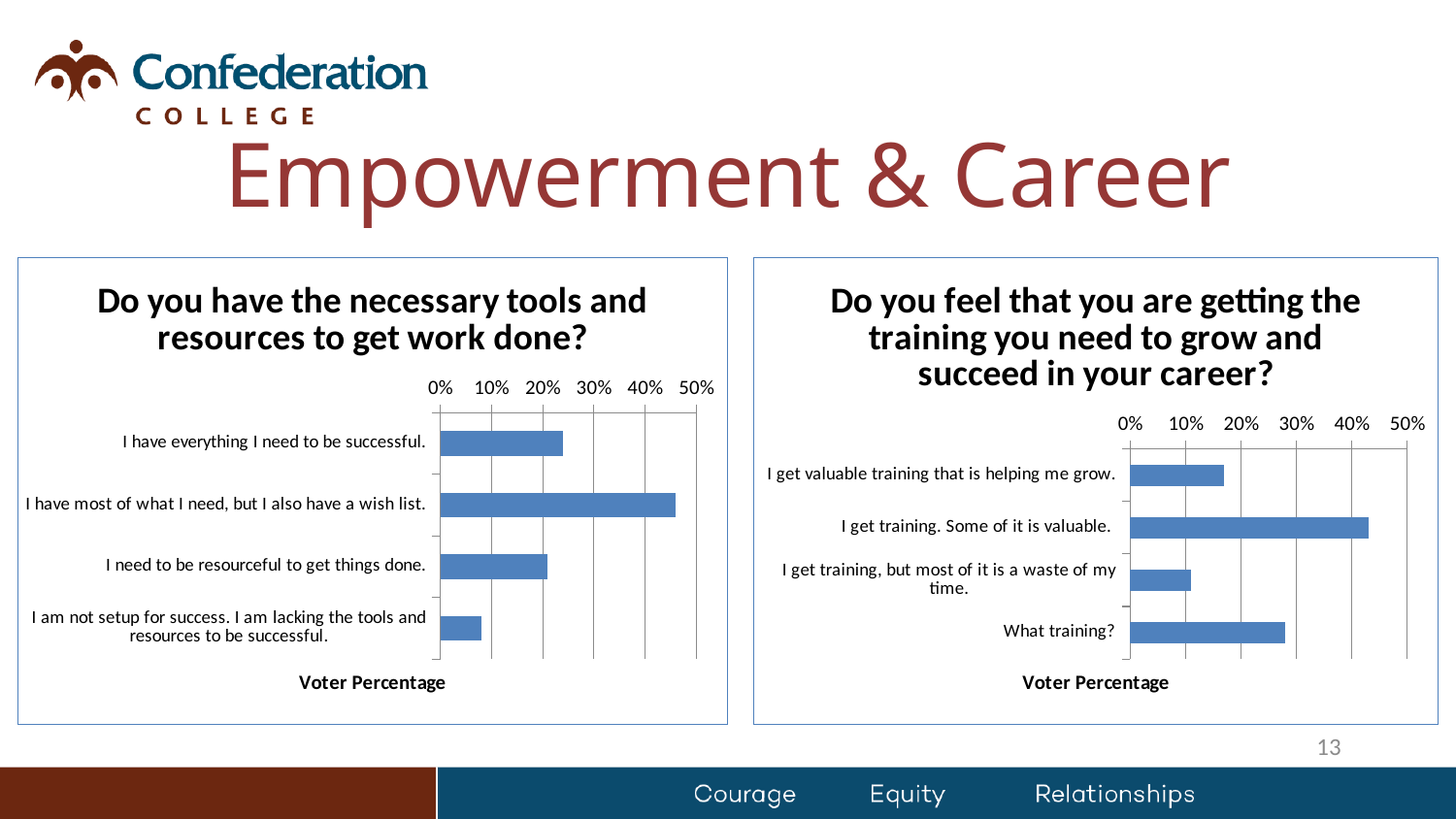
On the chart titled "Do you feel that you are getting the training you need to grow and succeed in your career?", which category has the highest voter percentage? I get training. Some of it is valuable. On the chart titled "Do you have the necessary tools and resources to get work done?", which category has the highest voter percentage? I have most of what I need, but I also have a wish list. On the chart titled "Do you feel that you are getting the training you need to grow and succeed in your career?", what is the label on the horizontal axis? Voter Percentage On the chart titled "Do you feel that you are getting the training you need to grow and succeed in your career?", which is larger: the value for "What training?" or the value for "I get valuable training that is helping me grow."? What training? On the chart titled "Do you feel that you are getting the training you need to grow and succeed in your career?", is the value for "I get training. Some of it is valuable." greater or less than 40%? greater On the chart titled "Do you have the necessary tools and resources to get work done?", is the value for "I am not setup for success. I am lacking the tools and resources to be successful." greater or less than 10%? less On the chart titled "Do you feel that you are getting the training you need to grow and succeed in your career?", which category has the lowest voter percentage? I get training, but most of it is a waste of my time. On the chart titled "Do you feel that you are getting the training you need to grow and succeed in your career?", how many categories are shown? 4 On the chart titled "Do you have the necessary tools and resources to get work done?", is the value for "I have most of what I need, but I also have a wish list." greater or less than 40%? greater On the chart titled "Do you have the necessary tools and resources to get work done?", what kind of chart is it? Bar chart On the chart titled "Do you have the necessary tools and resources to get work done?", which category has the lowest voter percentage? I am not setup for success. I am lacking the tools and resources to be successful. On the chart titled "Do you have the necessary tools and resources to get work done?", how many categories are shown? 4